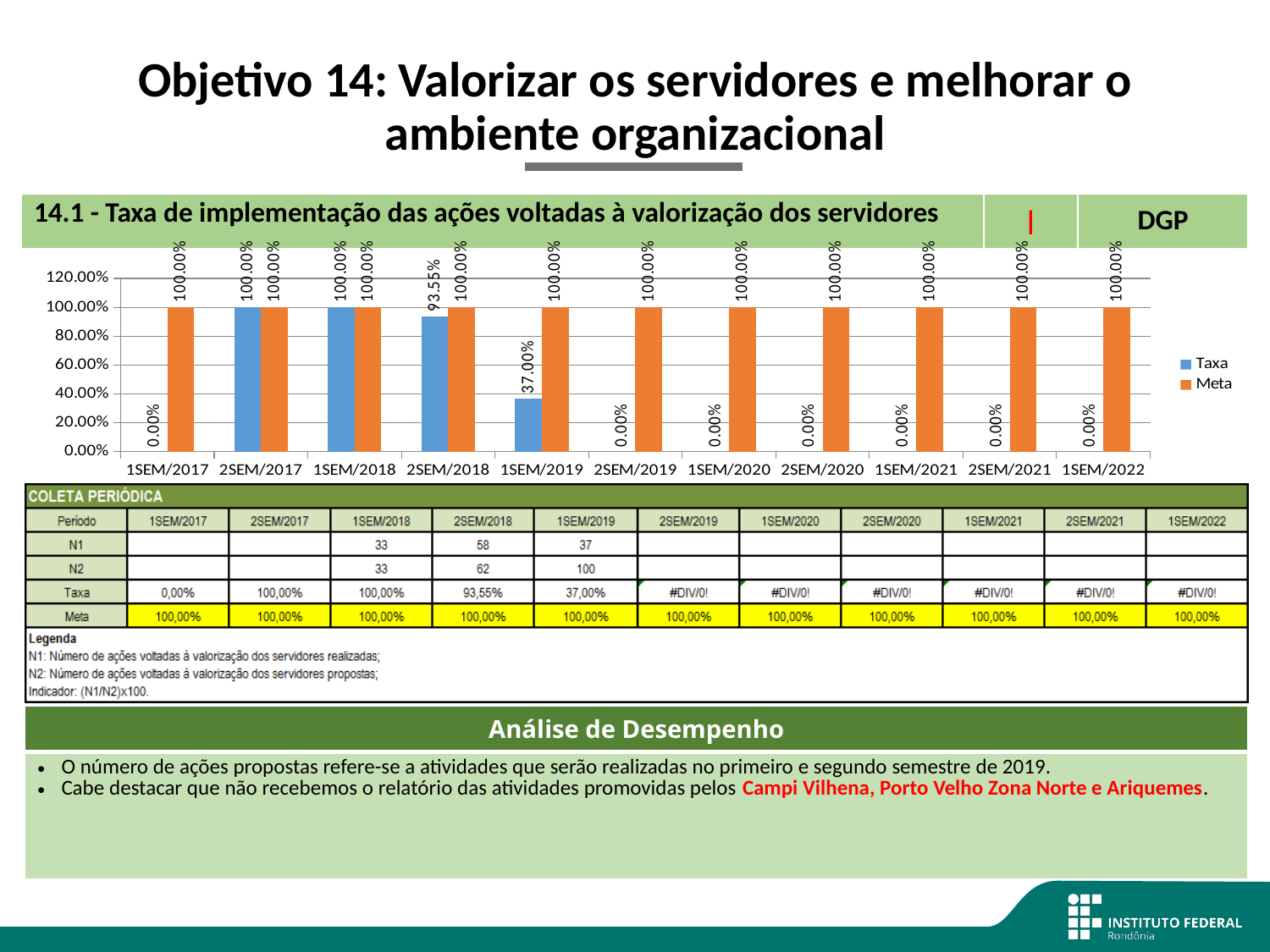
What is the Taxa value for 1SEM/2017? 0.00% What is the difference between the Meta and Taxa values for 1SEM/2019? 63.00% Which series is shown in orange in the chart? Meta Which is larger, the Taxa value for 2SEM/2018 or the Taxa value for 1SEM/2019? 2SEM/2018 How many series does the chart legend list? 2 How many periods are shown on the x axis of the chart? 11 Does the Taxa value rise or fall from 2SEM/2018 to 1SEM/2019? fall What is the Meta value for 1SEM/2022? 100.00% Is the Taxa value for 1SEM/2019 greater or less than 40.00%? less What is the Taxa value for 2SEM/2018? 93.55% What type of chart is shown on the slide? bar chart What is the Taxa value for 1SEM/2019? 37.00%